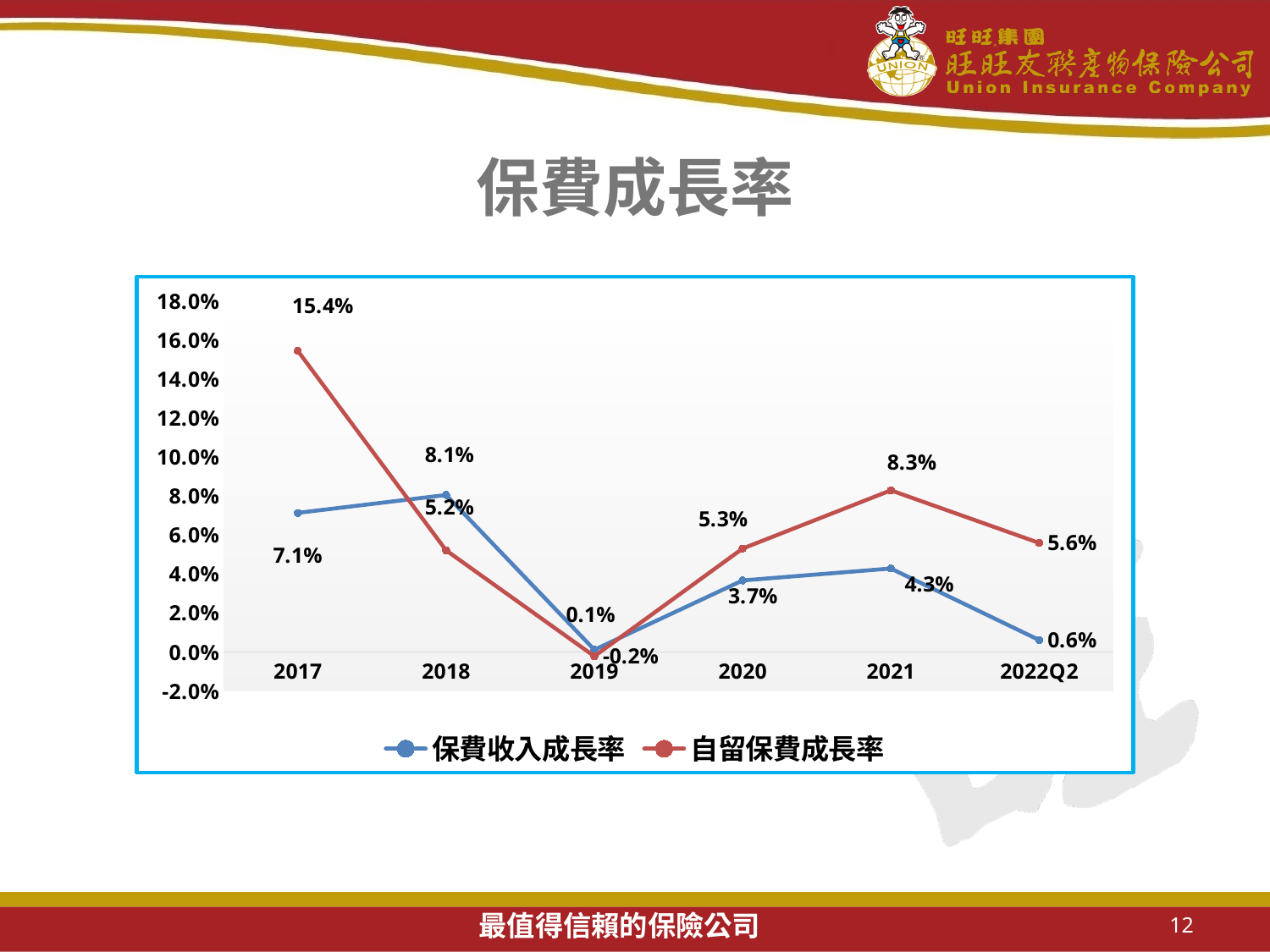
How many time periods are shown on the x axis? 6 Which series has the larger value in 2018, 保費收入成長率 or 自留保費成長率? 保費收入成長率 What is the value of 保費收入成長率 in 2018? 8.1% What is the difference between 自留保費成長率 and 保費收入成長率 in 2021? 4.0% What is the value of 自留保費成長率 in 2017? 15.4% What is the value of 保費收入成長率 in 2022Q2? 0.6% What is the value of 自留保費成長率 in 2019? -0.2% How many series does the legend list? 2 In which year is 保費收入成長率 the lowest? 2019 What type of chart is shown on the slide? line chart In which year is 自留保費成長率 the highest? 2017 What is the title of the chart? 保費成長率